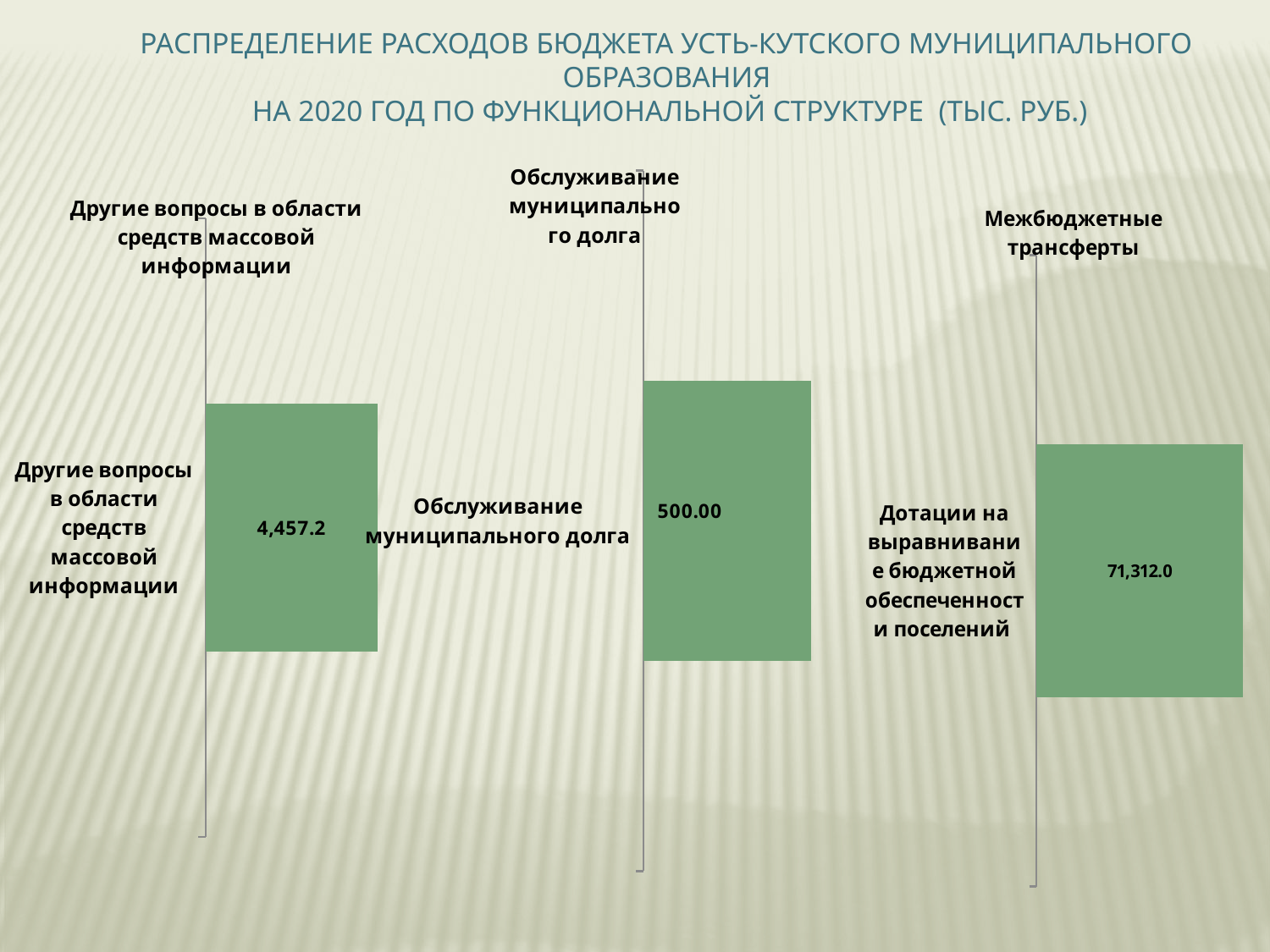
How many separate charts are shown on the slide? 3 In the chart titled 'Межбюджетные трансферты', what value is shown for 'Дотации на выравнивание бюджетной обеспеченности поселений'? 71,312.0 How many bars are plotted in the chart titled 'Обслуживание муниципального долга'? 1 What kind of chart is the chart titled 'Межбюджетные трансферты'? bar chart In the chart titled 'Другие вопросы в области средств массовой информации', what value is shown on the bar? 4,457.2 What is the difference between the value in the chart titled 'Другие вопросы в области средств массовой информации' (4,457.2) and the value in the chart titled 'Обслуживание муниципального долга' (500.00)? 3,957.2 Which is larger: the value in the chart titled 'Другие вопросы в области средств массовой информации' or the value in the chart titled 'Обслуживание муниципального долга'? Другие вопросы в области средств массовой информации (4,457.2) In the chart titled 'Обслуживание муниципального долга', what value is shown on the bar? 500.00 In the chart titled 'Межбюджетные трансферты', what is the label of the plotted category? Дотации на выравнивание бюджетной обеспеченности поселений What is the difference between the value in the chart titled 'Межбюджетные трансферты' (71,312.0) and the value in the chart titled 'Другие вопросы в области средств массовой информации' (4,457.2)? 66,854.8 Which is larger: the value in the chart titled 'Межбюджетные трансферты' (71,312.0) or the value in the chart titled 'Другие вопросы в области средств массовой информации' (4,457.2)? Межбюджетные трансферты (71,312.0) Across the three charts on the slide, which chart shows the smallest value? Обслуживание муниципального долга